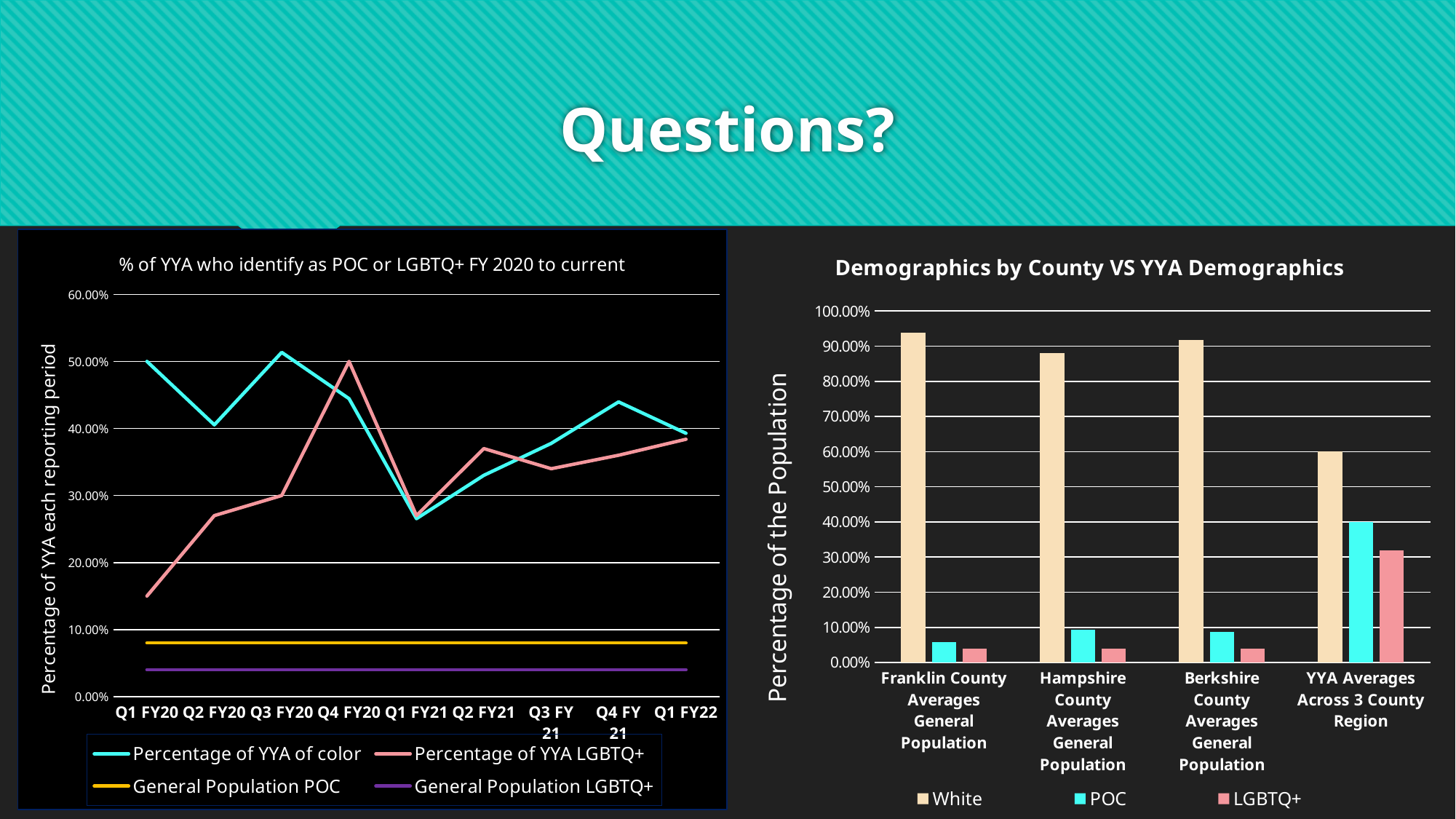
What kind of chart is the right chart, 'Demographics by County VS YYA Demographics'? Bar chart In the left chart, how many series does the legend list? 4 In the right chart, how many categories are shown on the x axis? 4 What kind of chart is the left chart, '% of YYA who identify as POC or LGBTQ+ FY 2020 to current'? Line chart In the left chart, does the Percentage of YYA LGBTQ+ rise or fall from Q1 FY20 to Q4 FY20? rise In the right chart, which category has the lowest White bar? YYA Averages Across 3 County Region In the left chart, how many reporting periods are shown on the x axis? 9 In the right chart, for YYA Averages Across 3 County Region, which is larger: POC or LGBTQ+? POC In the left chart, which series has the lowest values across all reporting periods? General Population LGBTQ+ In the left chart, is the Percentage of YYA LGBTQ+ at Q1 FY20 greater or less than 20.00%? less In the right chart, is the POC value for YYA Averages Across 3 County Region greater or less than 30.00%? greater In the right chart, how many series does the legend list? 3